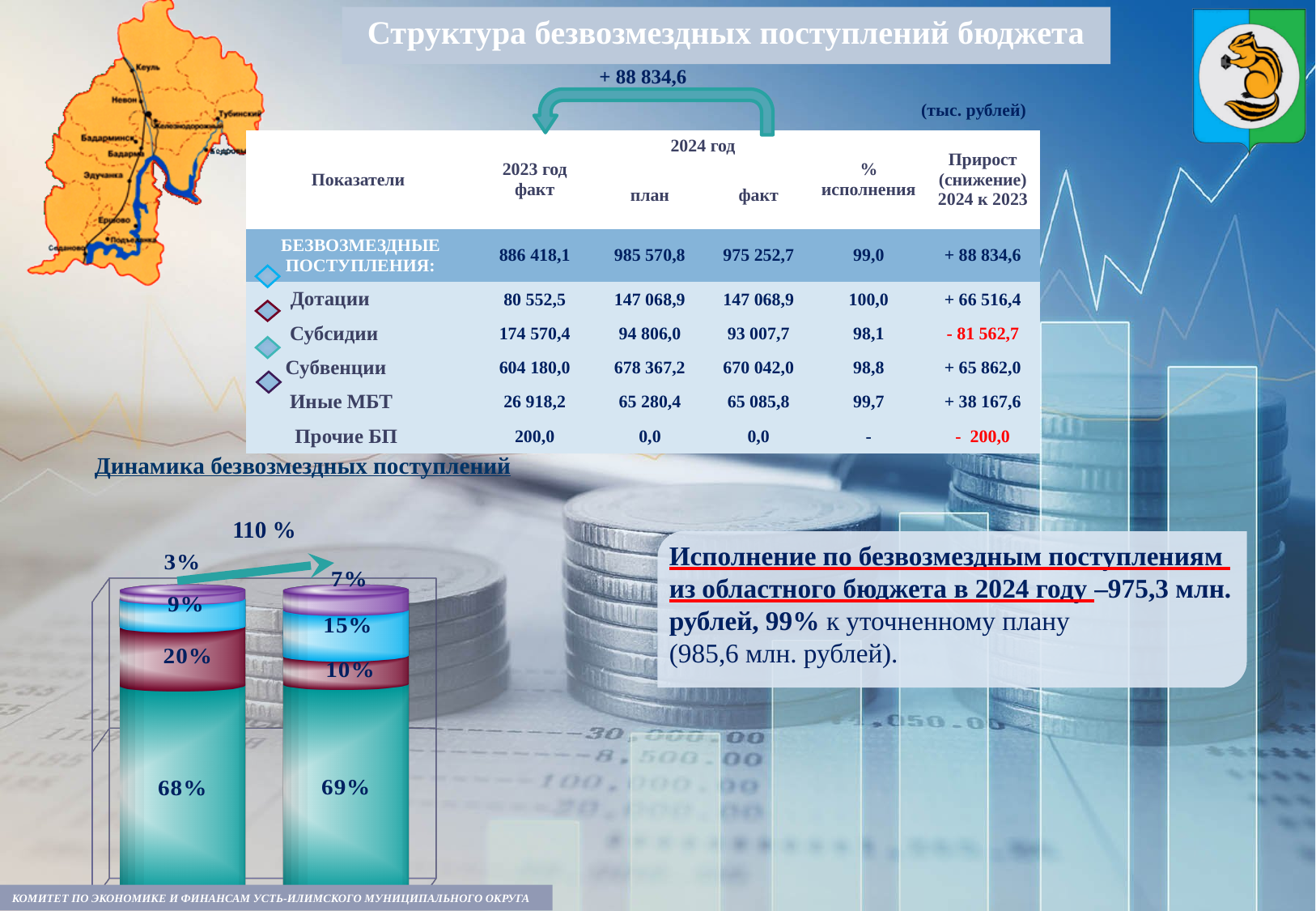
In the 'Динамика безвозмездных поступлений' chart, what is the value of the top (purple) segment of the right bar? 7% In the 'Динамика безвозмездных поступлений' chart, what is the value of the red segment of the left bar? 20% In the 'Динамика безвозмездных поступлений' chart, what is the value of the bottom (teal) segment of the right bar? 69% What percentage is written above the arrow between the two bars in the 'Динамика безвозмездных поступлений' chart? 110 % How many stacked bars does the 'Динамика безвозмездных поступлений' chart contain? 2 In the 'Динамика безвозмездных поступлений' chart, which bar has the larger red segment, the left or the right? Left In the 'Динамика безвозмездных поступлений' chart, what is the value of the bottom (teal) segment of the left bar? 68% What kind of chart is shown under the heading 'Динамика безвозмездных поступлений'? Stacked bar chart In the 'Динамика безвозмездных поступлений' chart, what is the value of the blue segment of the right bar? 15% In the 'Динамика безвозмездных поступлений' chart, what is the smallest segment value in the left bar? 3% In the 'Динамика безвозмездных поступлений' chart, what is the total of the four labelled segments of the left bar? 100% In the 'Динамика безвозмездных поступлений' chart, by how many percentage points does the blue segment of the right bar exceed the blue segment of the left bar? 6